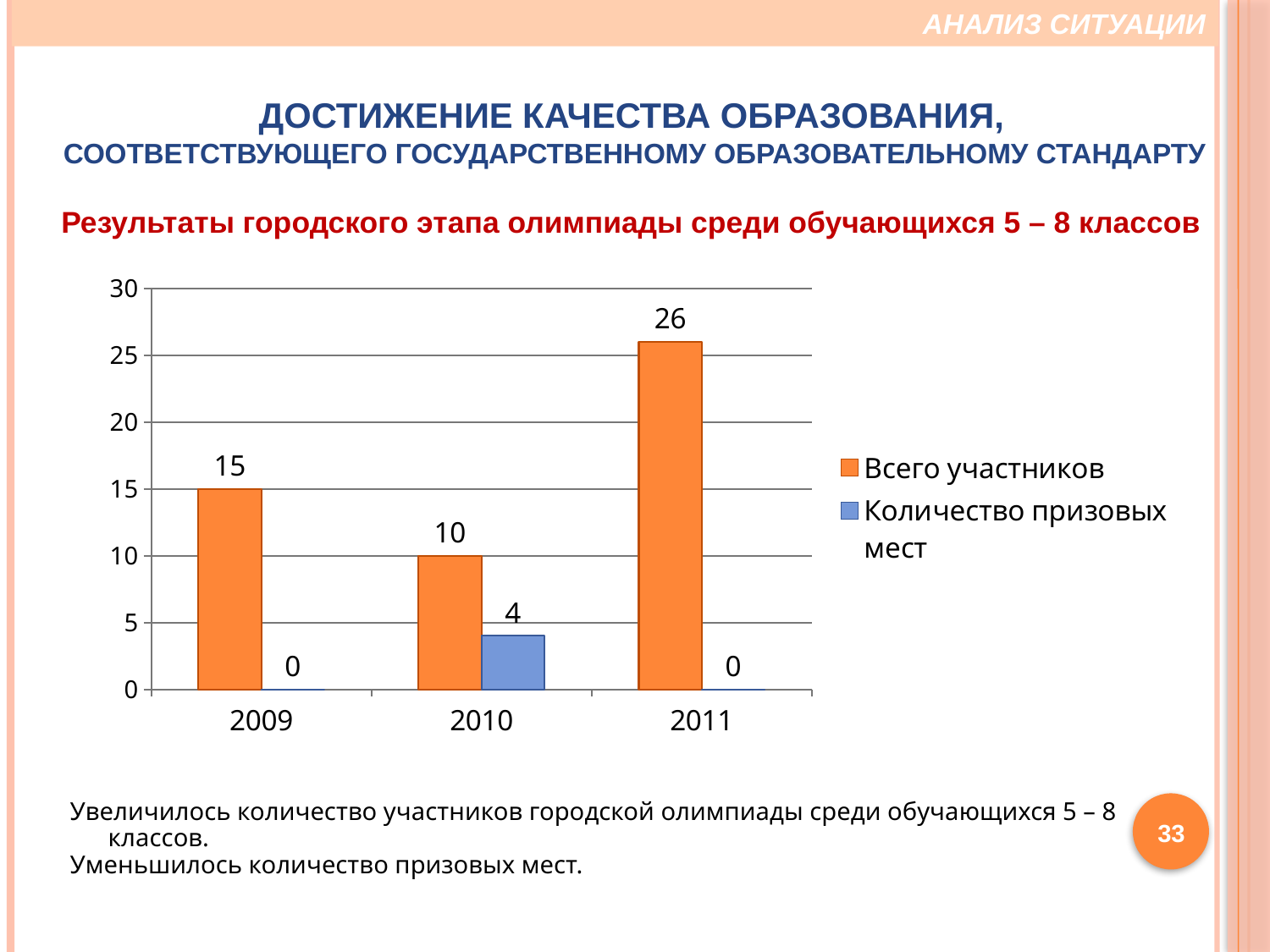
Which is larger: "Всего участников" in 2009 or in 2010? 2009 What is the value for "Количество призовых мест" in 2010? 4 How many years are shown on the x axis? 3 Which colour represents "Всего участников" in the chart? orange What is the difference between "Всего участников" in 2011 and in 2009? 11 What is the value for "Всего участников" in 2011? 26 Which year has the highest value for "Всего участников"? 2011 What kind of chart is shown on the slide? bar chart What is the difference between "Всего участников" and "Количество призовых мест" in 2010? 6 Which year has the lowest value for "Всего участников"? 2010 What is the value for "Всего участников" in 2009? 15 How many series does the legend list? 2